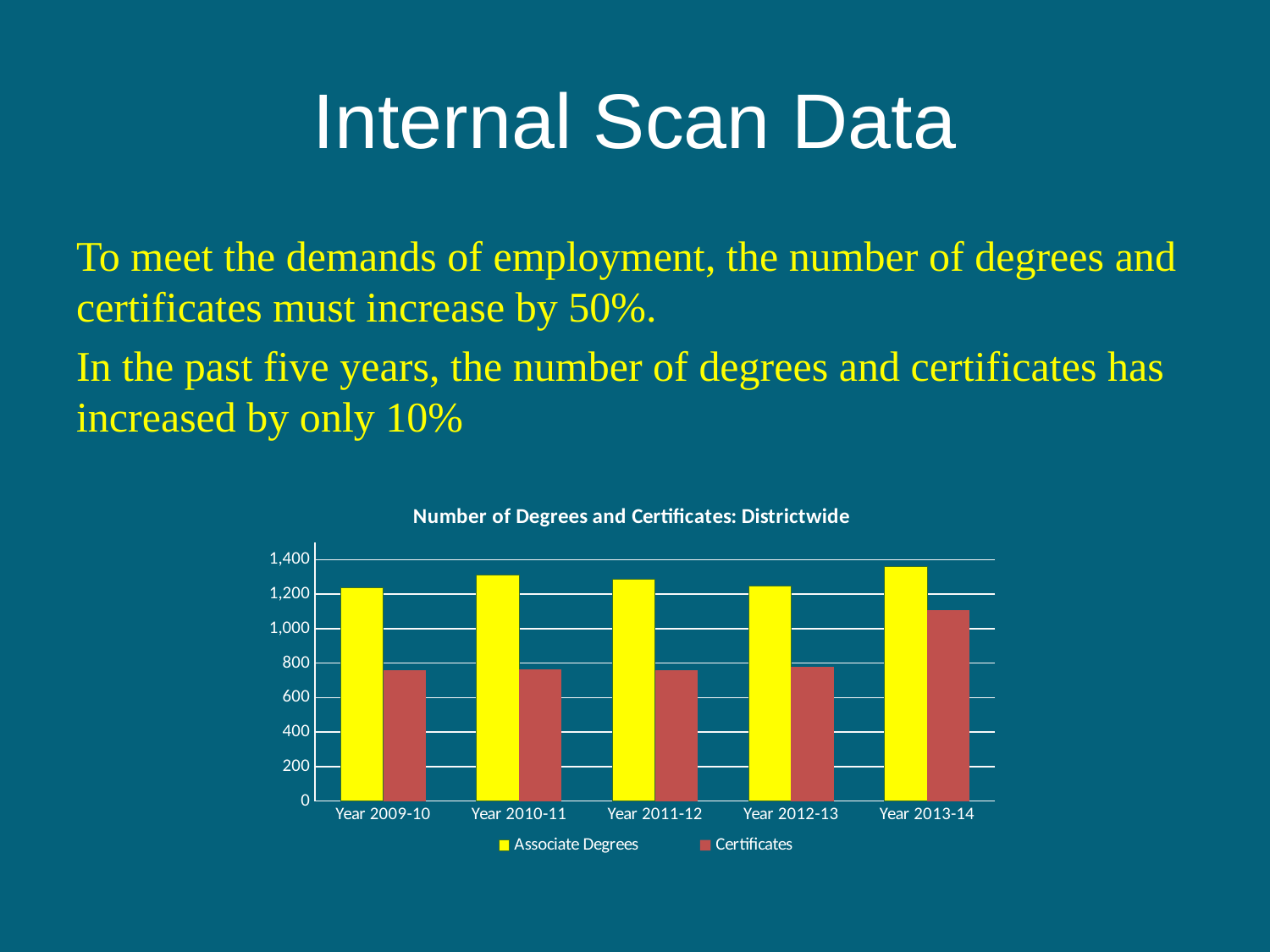
Is the value for Certificates in Year 2009-10 greater or less than 800? less How many series does the chart legend list? 2 For Certificates, which is larger: Year 2012-13 or Year 2013-14? Year 2013-14 What is the title of the chart? Number of Degrees and Certificates: Districtwide In Year 2011-12, which is larger: Associate Degrees or Certificates? Associate Degrees Is the value for Associate Degrees in Year 2010-11 greater or less than 1,000? greater Which year has the highest value for Associate Degrees? Year 2013-14 Which year has the highest value for Certificates? Year 2013-14 What kind of chart is shown on the slide? bar chart Is the value for Associate Degrees in Year 2013-14 greater or less than 1,200? greater How many years are shown on the x axis of the chart? 5